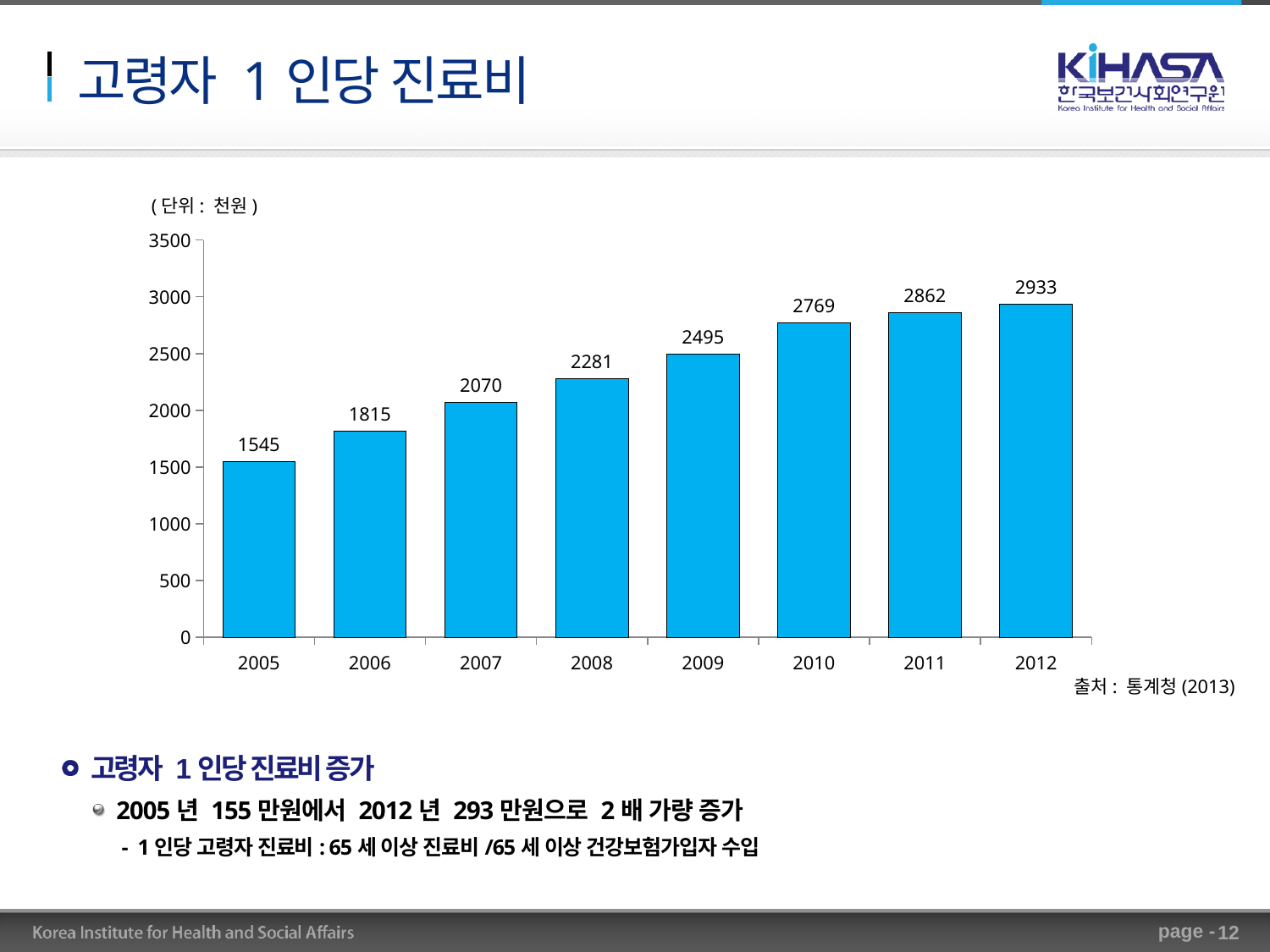
What is the value for 2012? 2933 What is the value for 2005? 1545 What is the difference between the values for 2012 and 2005? 1388 What kind of chart is shown on the slide? bar chart What is the value for 2009? 2495 What is the difference between the values for 2008 and 2007? 211 How many years are shown on the x axis? 8 Which is larger, the value for 2010 or the value for 2011? 2011 Which year has the highest value? 2012 Do the values rise or fall from 2005 to 2012? rise Is the value for 2006 greater or less than 2000? less Which year has the lowest value? 2005